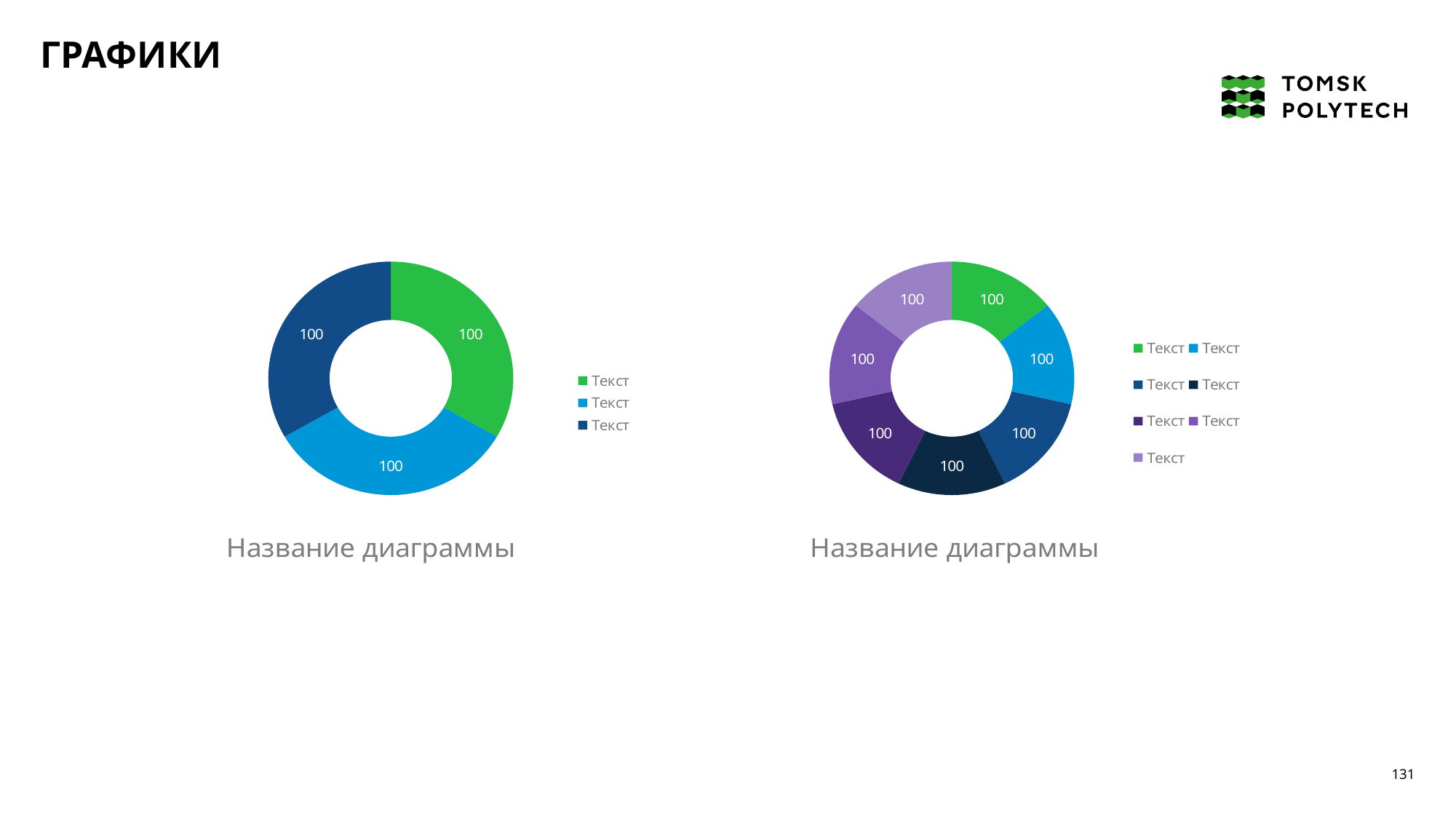
In the right chart, what is the total of all the slice values? 700 What kind of chart is the right chart on the slide? Doughnut (pie) chart What is the title of the right chart? Название диаграммы In the left chart, what is the difference between the green slice and the light blue slice? 0 In the left chart, how many slices does the doughnut have? 3 In the right chart, what is the value shown on the light purple slice? 100 In the left chart, what is the value shown on the green slice? 100 In the left chart, how many entries does the legend list? 3 In the right chart, how many entries does the legend list? 7 In the right chart, how many slices does the doughnut have? 7 In the left chart, what is the total of all the slice values? 300 What kind of chart is the left chart on the slide? Doughnut (pie) chart